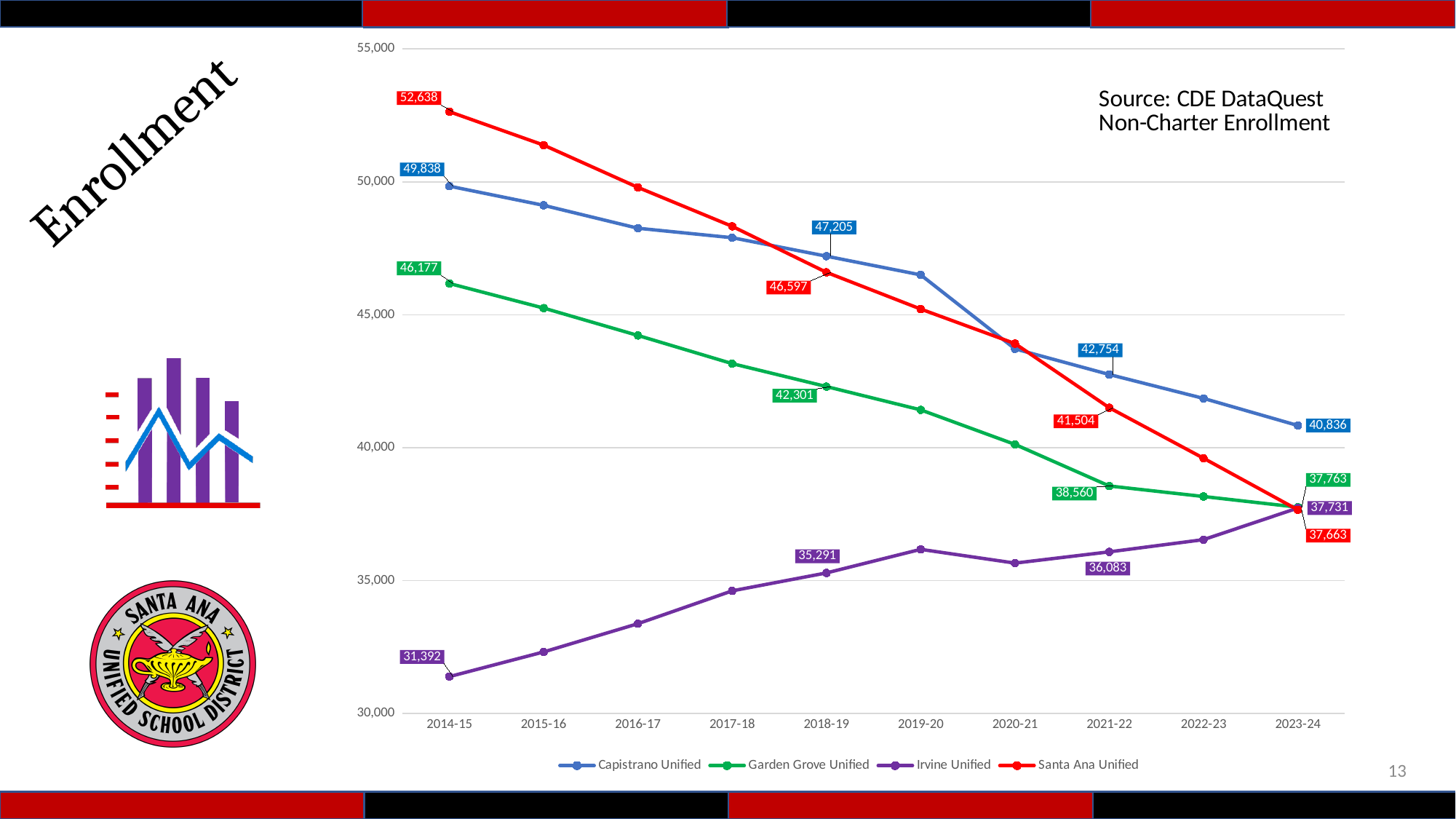
What was the enrollment for Garden Grove Unified in 2018-19? 42,301 Is the value for Santa Ana Unified in 2020-21 greater or less than 45,000? less Does Irvine Unified enrollment rise or fall from 2014-15 to 2023-24? rise How many school years are shown on the x axis? 10 By how much did Irvine Unified enrollment grow from 2014-15 to 2023-24? 6,339 What kind of chart is shown on the slide? line chart What was the enrollment for Santa Ana Unified in 2014-15? 52,638 What was the enrollment for Irvine Unified in 2023-24? 37,731 Which district had the highest enrollment in 2014-15? Santa Ana Unified Which district had the lowest enrollment in 2014-15? Irvine Unified How many districts are listed in the legend? 4 By how much did Santa Ana Unified enrollment fall from 2014-15 to 2023-24? 14,975